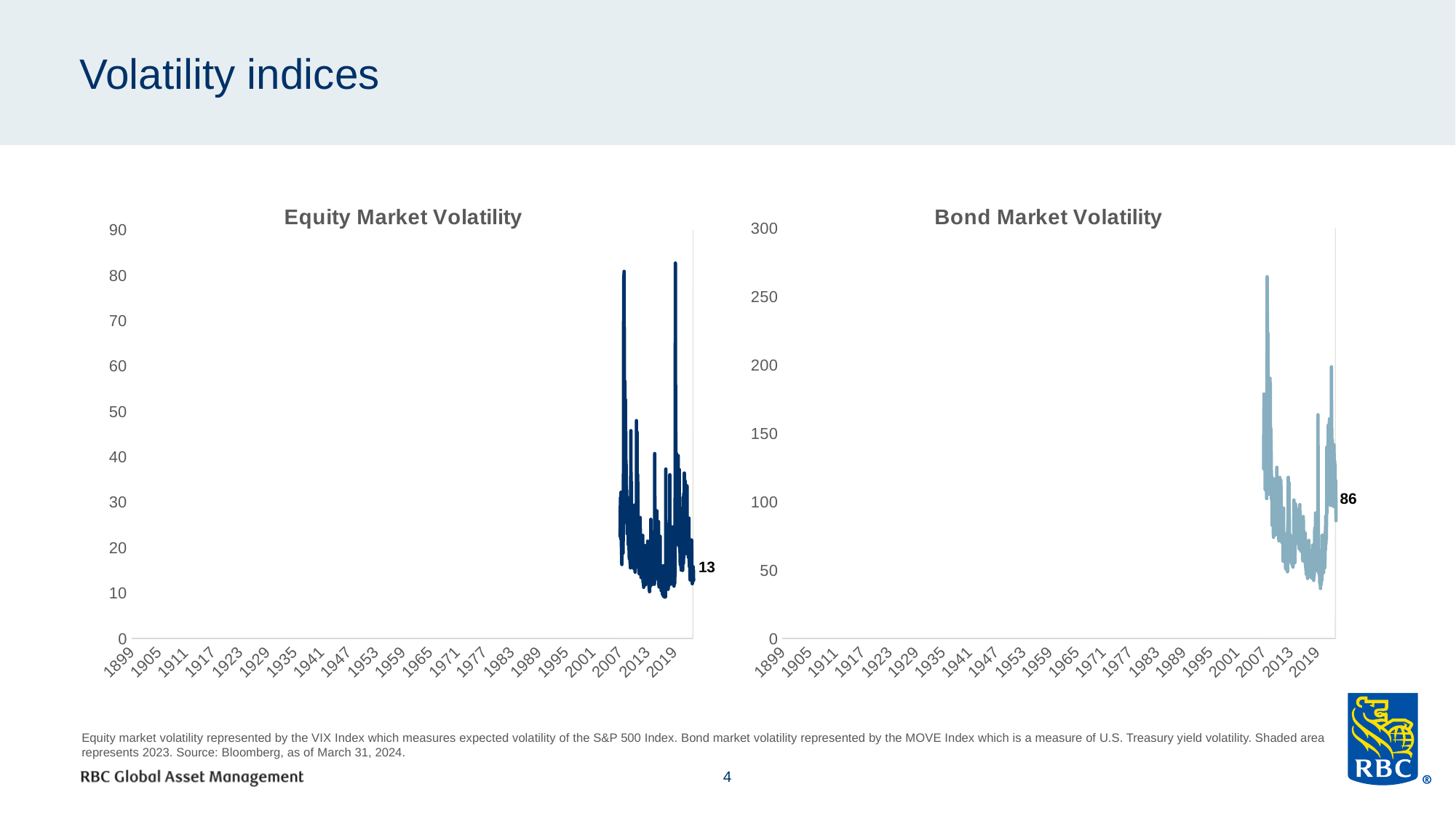
On the Equity Market Volatility chart, what is the value shown by the data label at the end of the line? 13 On the Bond Market Volatility chart, is the highest point of the line greater or less than 250? greater On the Equity Market Volatility chart, is the labelled end value greater or less than 20? less What kind of chart is the Equity Market Volatility chart? Line chart What is the difference between the labelled end value on the Bond Market Volatility chart and the labelled end value on the Equity Market Volatility chart? 73 What is the highest value shown on the y-axis of the Bond Market Volatility chart? 300 On the Bond Market Volatility chart, what is the value shown by the data label at the end of the line? 86 How many charts are shown on the slide? 2 On the Bond Market Volatility chart, is the labelled end value greater or less than 100? less Which chart has the larger labelled end value, Equity Market Volatility or Bond Market Volatility? Bond Market Volatility What is the title of the chart on the right side of the slide? Bond Market Volatility